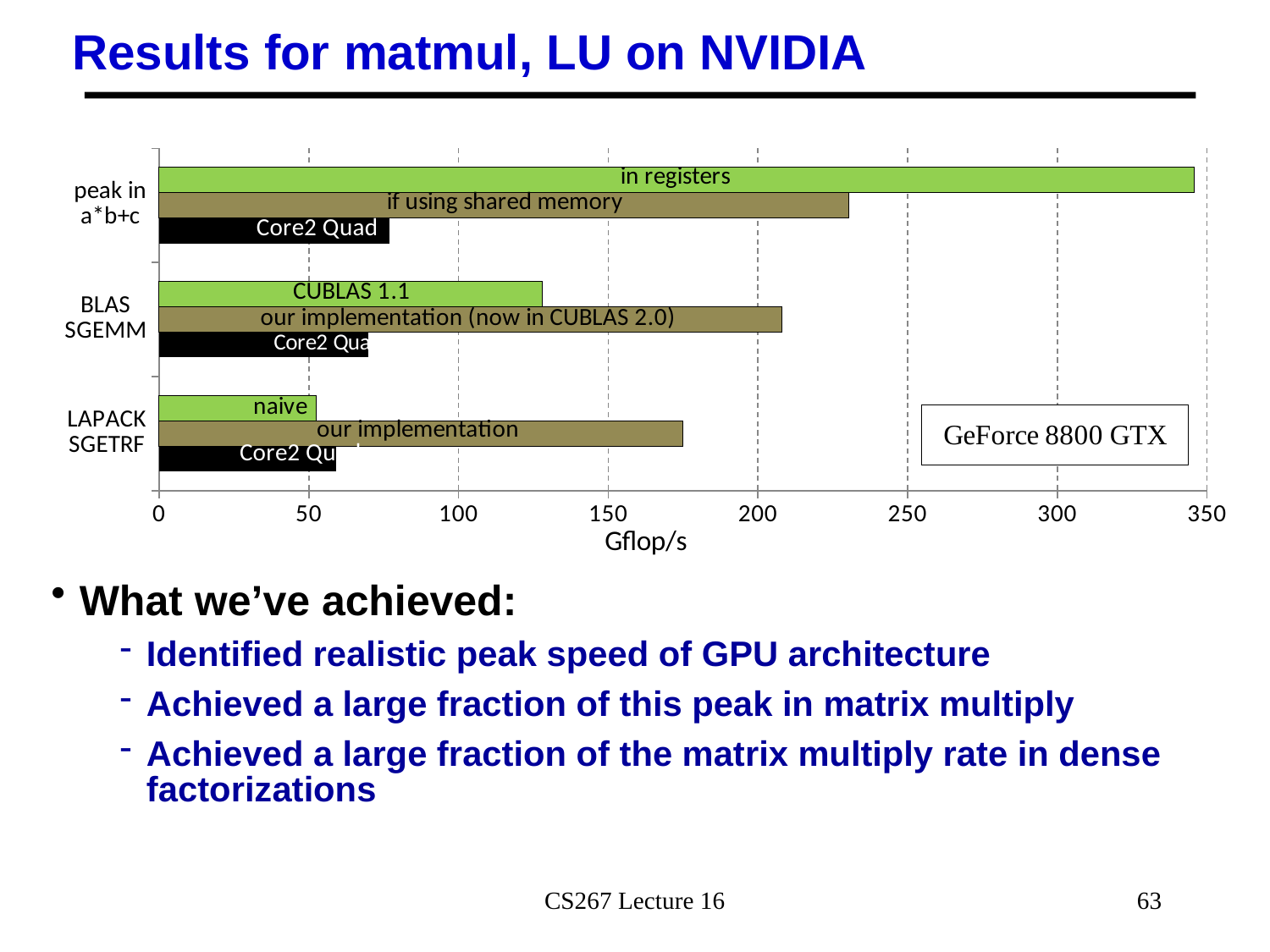
Is the value for 'naive' in the LAPACK SGETRF group greater or less than 100? less How many category groups are shown on the y axis of the chart? 3 In the BLAS SGEMM group, which is larger: CUBLAS 1.1 or 'our implementation (now in CUBLAS 2.0)'? our implementation (now in CUBLAS 2.0) What kind of chart is shown on the slide? bar chart Which bar is the longest in the chart? in registers In the LAPACK SGETRF group, which is larger: 'naive' or 'our implementation'? our implementation What unit is shown on the x axis of the chart? Gflop/s Is the value for Core2 Quad in the peak in a*b+c group greater or less than 100? less Is the value for CUBLAS 1.1 in the BLAS SGEMM group greater or less than 100? greater Which GPU is named in the box on the chart? GeForce 8800 GTX